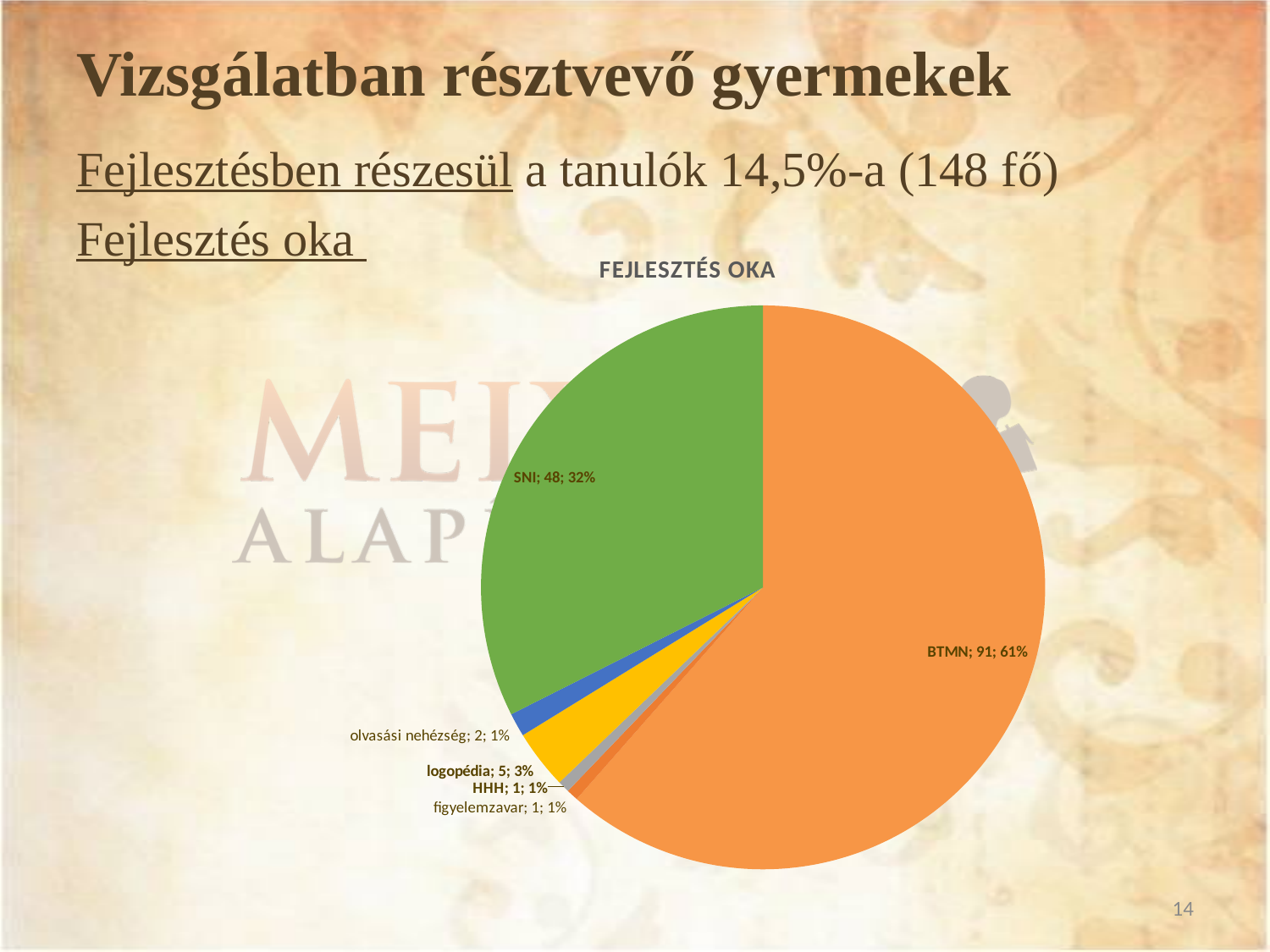
What is the value for BTMN? 91 What share of the pie does SNI represent? 32% What type of chart is shown on the slide? pie chart Which category has the largest slice? BTMN What is the title of the chart? FEJLESZTÉS OKA What is the value for logopédia? 5 What is the value for olvasási nehézség? 2 How many slices does the pie chart have? 6 What is the value for SNI? 48 What share of the pie does BTMN represent? 61% What is the difference between the values for BTMN and SNI? 43 Which is larger, the value for logopédia or the value for olvasási nehézség? logopédia